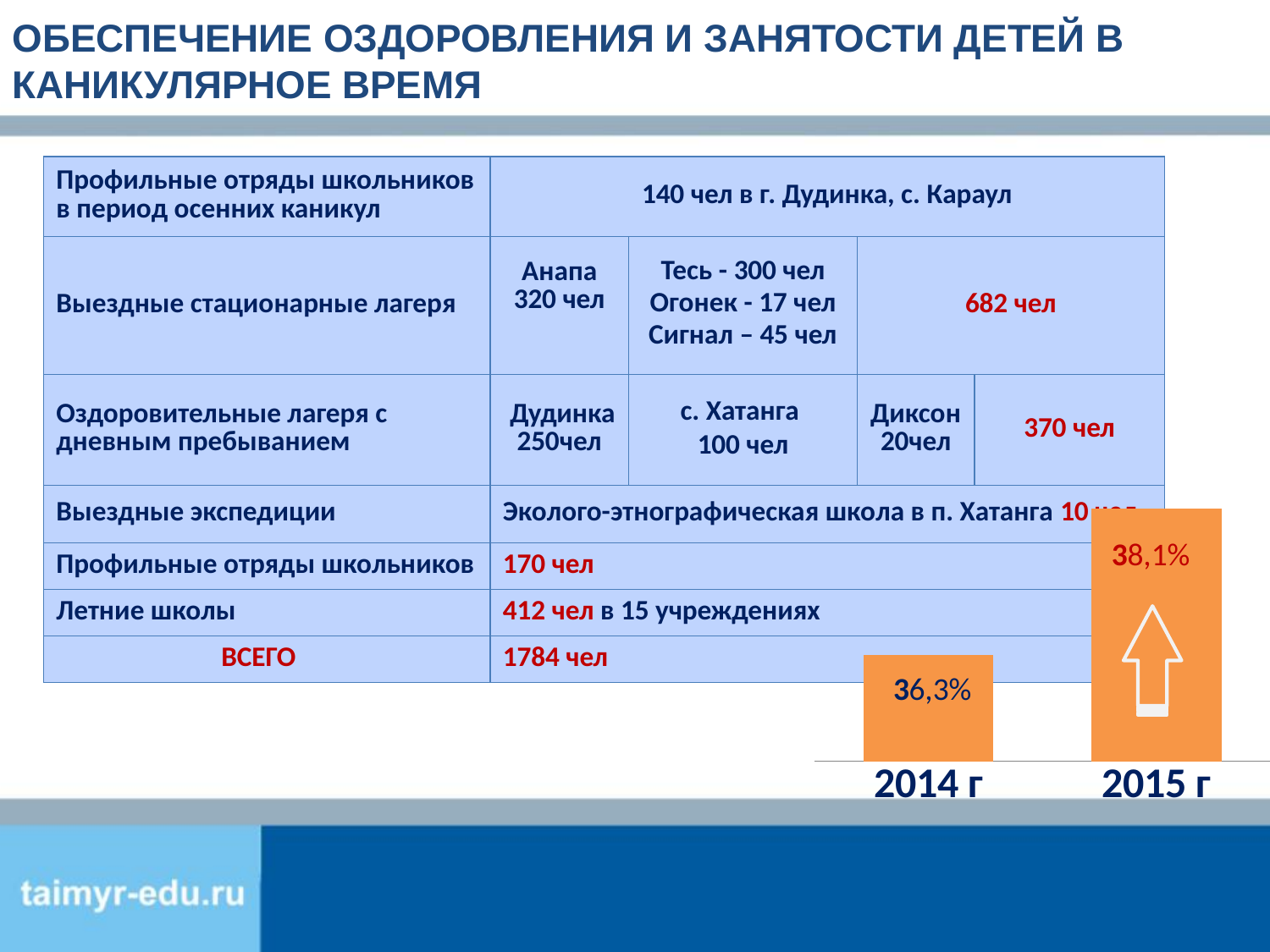
In the bar chart at the bottom right of the slide, what is the value for 2015 г? 38,1% In the bar chart at the bottom right of the slide, which bar contains an upward-pointing arrow? 2015 г In the bar chart at the bottom right of the slide, what is the difference between the 2015 г value and the 2014 г value? 1,8% In the bar chart at the bottom right of the slide, which year has the higher value? 2015 г In the bar chart at the bottom right of the slide, is the value for 2015 г larger or smaller than the value for 2014 г? larger What colour are the bars in the chart at the bottom right of the slide? orange In the bar chart at the bottom right of the slide, what is the value for 2014 г? 36,3% In the bar chart at the bottom right of the slide, do the values rise or fall from 2014 г to 2015 г? rise What kind of chart is shown at the bottom right of the slide? bar chart In the bar chart at the bottom right of the slide, which year has the lower value? 2014 г How many bars are shown in the bar chart at the bottom right of the slide? 2